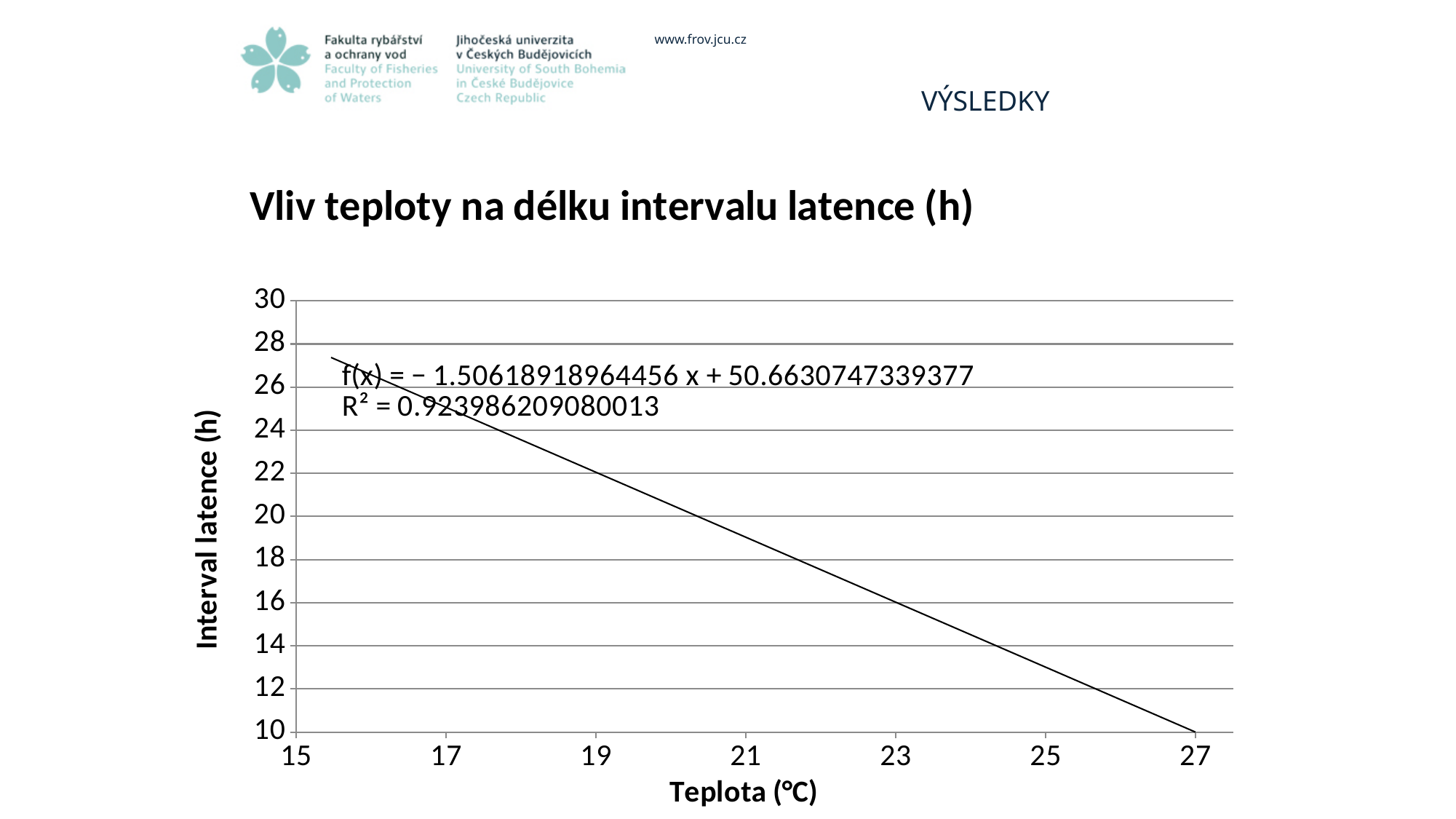
Is the value of the line at 25 °C greater or less than 14? less Is the value of the line at 21 °C greater or less than 18? greater Does the interval latence value rise or fall as temperature increases along the x axis? fall Is the value of the line at 17 °C larger or smaller than its value at 23 °C? larger Is the value of the line at 25 °C greater or less than 12? greater What kind of chart is shown on the slide? line chart What R² value is printed on the chart? R² = 0.923986209080013 What is the title of the chart? Vliv teploty na délku intervalu latence (h)